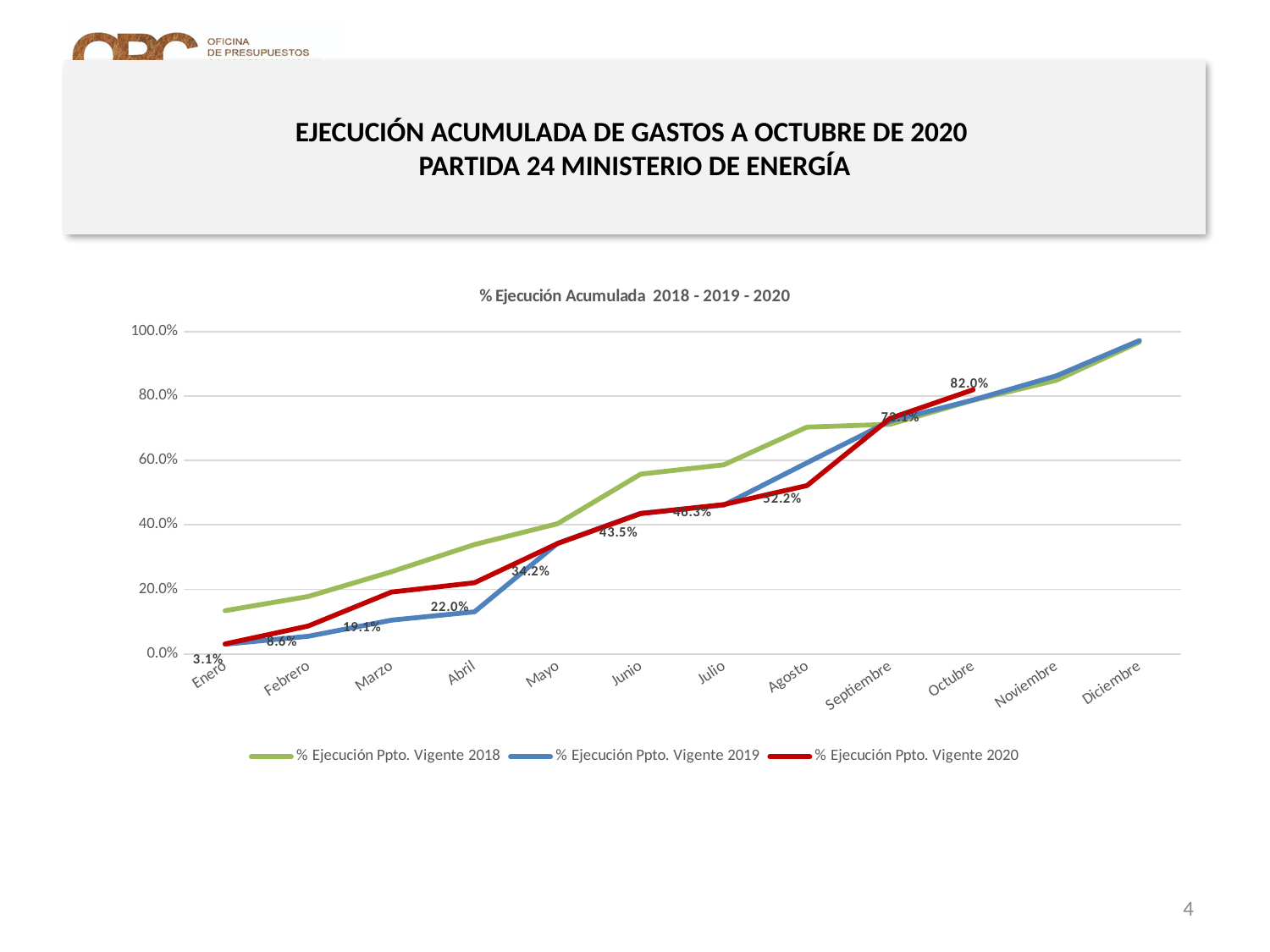
What is the value of % Ejecución Ppto. Vigente 2020 in Enero? 3.1% What is the value of % Ejecución Ppto. Vigente 2020 in Junio? 43.5% What is the title of the chart? % Ejecución Acumulada 2018 - 2019 - 2020 What is the value of % Ejecución Ppto. Vigente 2020 in Abril? 22.0% What is the value of % Ejecución Ppto. Vigente 2020 in Octubre? 82.0% What kind of chart is shown on the slide? Line chart Is the value for % Ejecución Ppto. Vigente 2018 in Agosto greater or less than 60.0%? greater Does the % Ejecución Ppto. Vigente 2020 series rise or fall from Enero to Octubre? Rise In Abril, which series is higher: % Ejecución Ppto. Vigente 2018 or % Ejecución Ppto. Vigente 2020? % Ejecución Ppto. Vigente 2018 How many months are shown along the x axis? 12 By how many percentage points does the 2020 series increase from Agosto (52.2%) to Octubre (82.0%)? 29.8 percentage points How many series does the legend list? 3